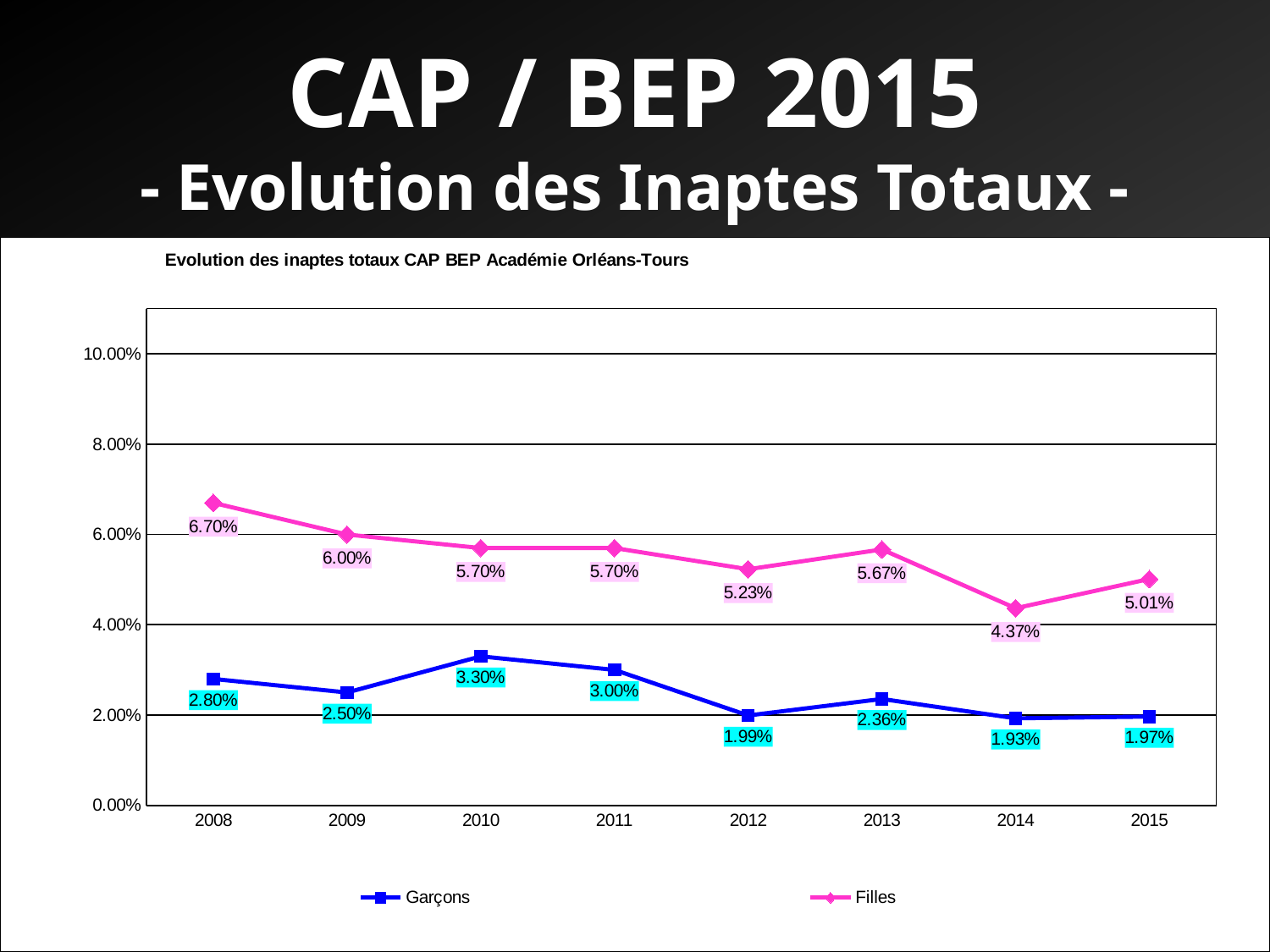
Which is larger, the Garçons value in 2011 or the Garçons value in 2012? 2011 Does the Filles series overall rise or fall from 2008 to 2015? fall How many series does the legend list? 2 What is the value for Garçons in 2014? 1.93% In which year is the Filles value lowest? 2014 What is the difference between the Filles and Garçons values in 2015? 3.04% What is the value for Garçons in 2010? 3.30% What type of chart is shown on the slide? line chart In which year is the Garçons value highest? 2010 What is the title of the chart? Evolution des inaptes totaux CAP BEP Académie Orléans-Tours What is the value for Filles in 2008? 6.70% How many years are shown on the x axis? 8